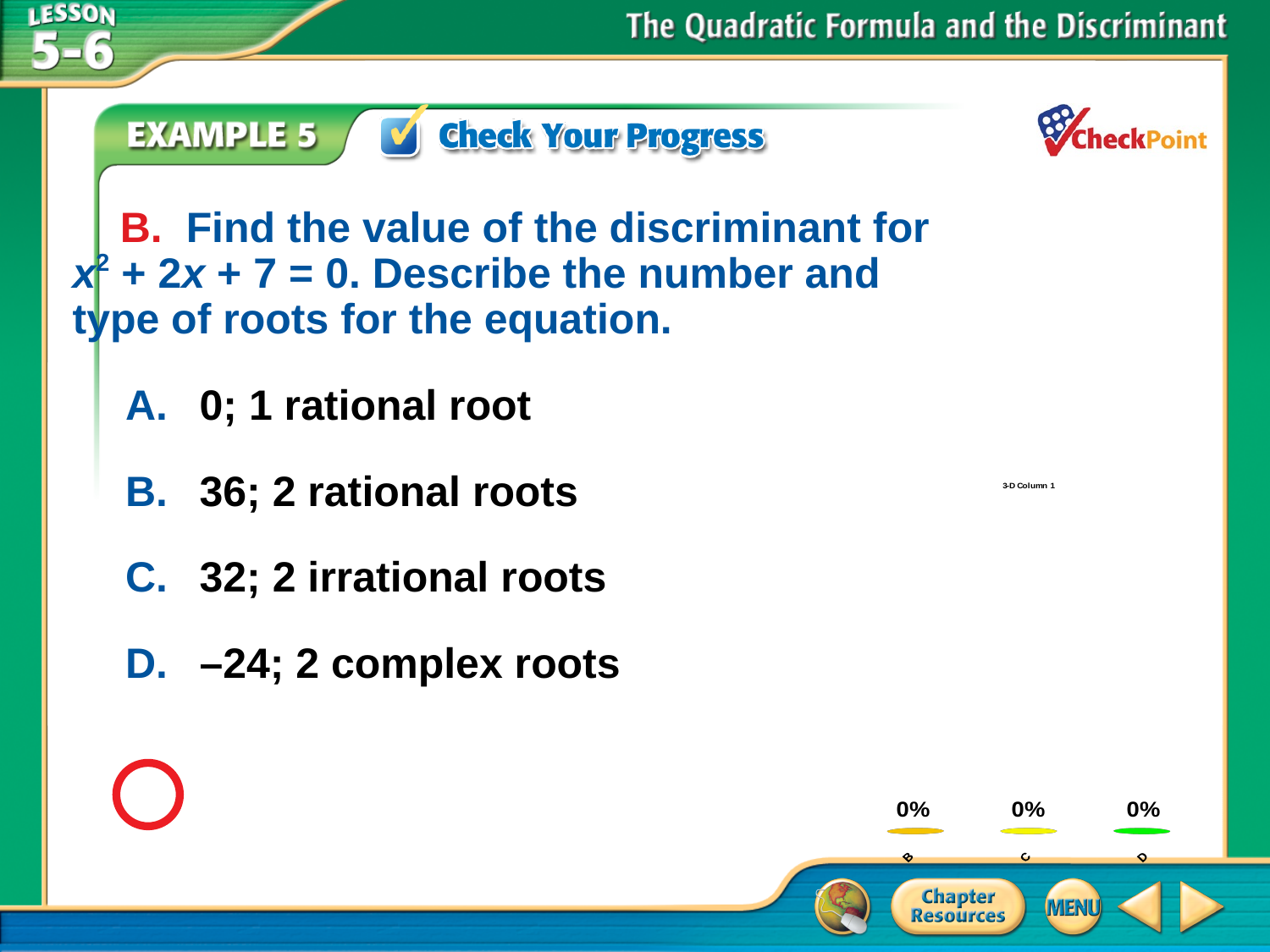
What value is shown for category B in the chart? 0% Do the values for B, C and D in the chart rise, fall, or stay the same? stay the same What is the title of the chart on the slide? 3-D Column 1 What value is shown for category C in the chart? 0% What value is shown for category D in the chart? 0% What is the difference between the values for B and D in the chart? 0% What kind of chart is shown on the slide? bar chart